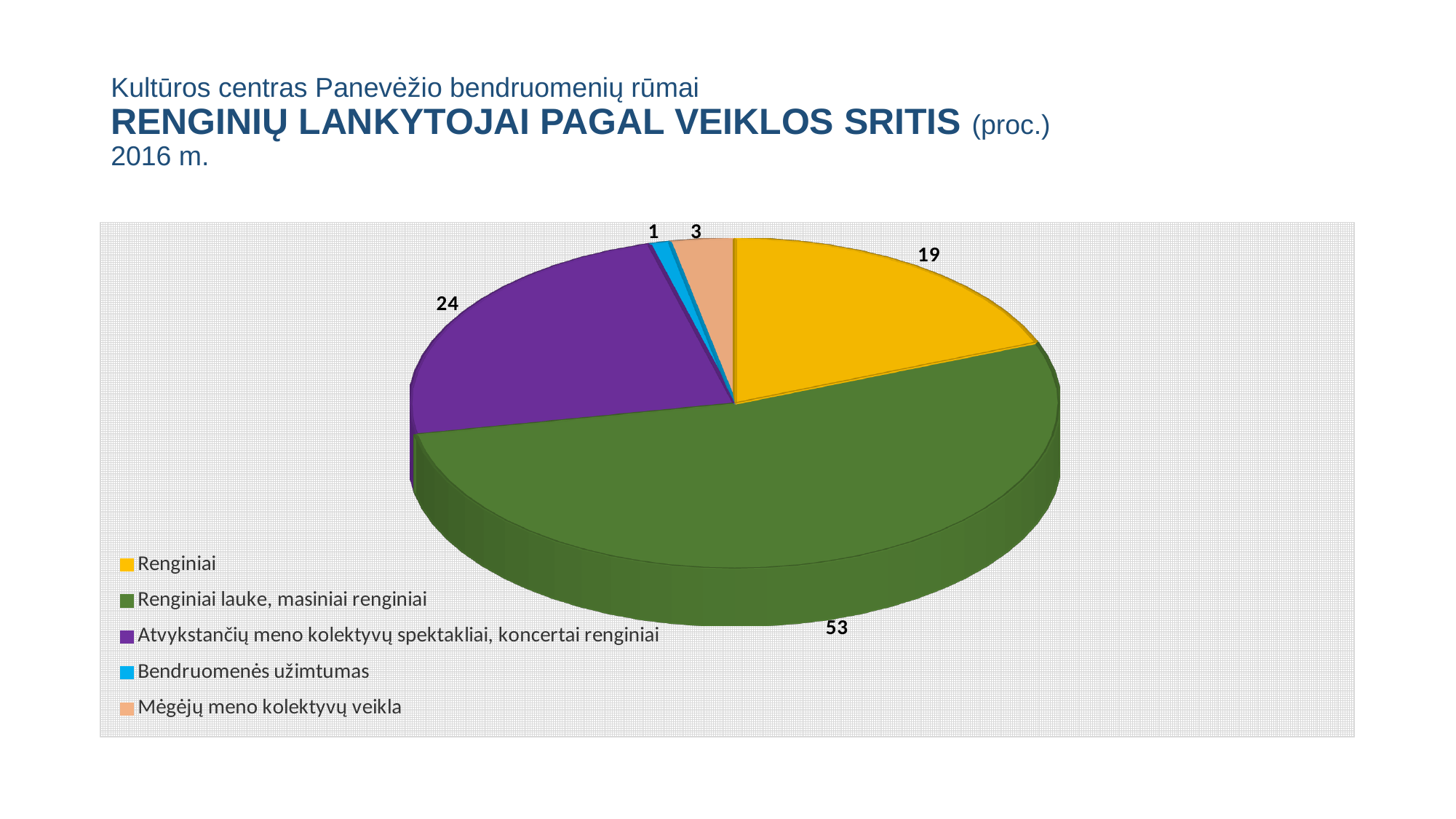
What is the difference between the values for Renginiai lauke, masiniai renginiai and Atvykstančių meno kolektyvų spektakliai, koncertai renginiai? 29 How many categories does the pie chart have? 5 Which category has the largest share of the pie? Renginiai lauke, masiniai renginiai Which is larger, the value for Renginiai or the value for Atvykstančių meno kolektyvų spektakliai, koncertai renginiai? Atvykstančių meno kolektyvų spektakliai, koncertai renginiai What is the value for Bendruomenės užimtumas? 1 What kind of chart is shown on the slide? pie chart What is the value for Renginiai? 19 What is the value for Atvykstančių meno kolektyvų spektakliai, koncertai renginiai? 24 Which colour represents Renginiai in the legend? yellow What is the value for Renginiai lauke, masiniai renginiai? 53 What is the value for Mėgėjų meno kolektyvų veikla? 3 Which category has the smallest share of the pie? Bendruomenės užimtumas